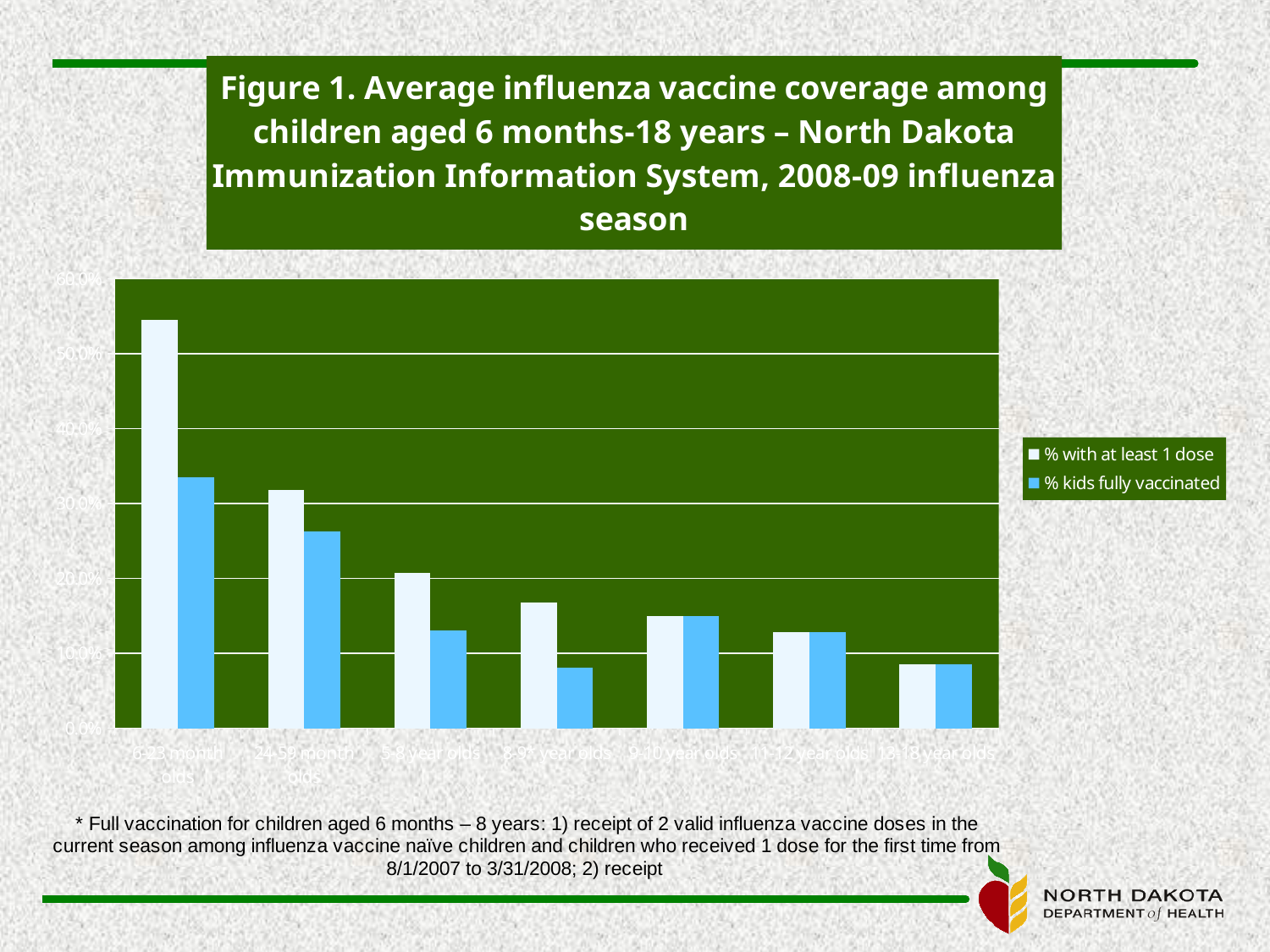
Which age group has the highest value for % with at least 1 dose? 6-23 month olds Which age group has the lowest value for % with at least 1 dose? 13-18 year olds How many series does the legend list? 2 Is the value for % with at least 1 dose among 24-59 month olds greater or less than 30.0%? greater Is the value for % with at least 1 dose among 6-23 month olds greater or less than 50.0%? greater Do the values for % with at least 1 dose generally rise or fall as age increases along the x axis? fall What kind of chart is shown on the slide? bar chart What is the second entry listed in the chart legend? % kids fully vaccinated Which is larger for 5-8 year olds: % with at least 1 dose or % kids fully vaccinated? % with at least 1 dose Is the value for % kids fully vaccinated among 6-23 month olds greater or less than 30.0%? greater How many age-group categories are plotted along the x axis? 7